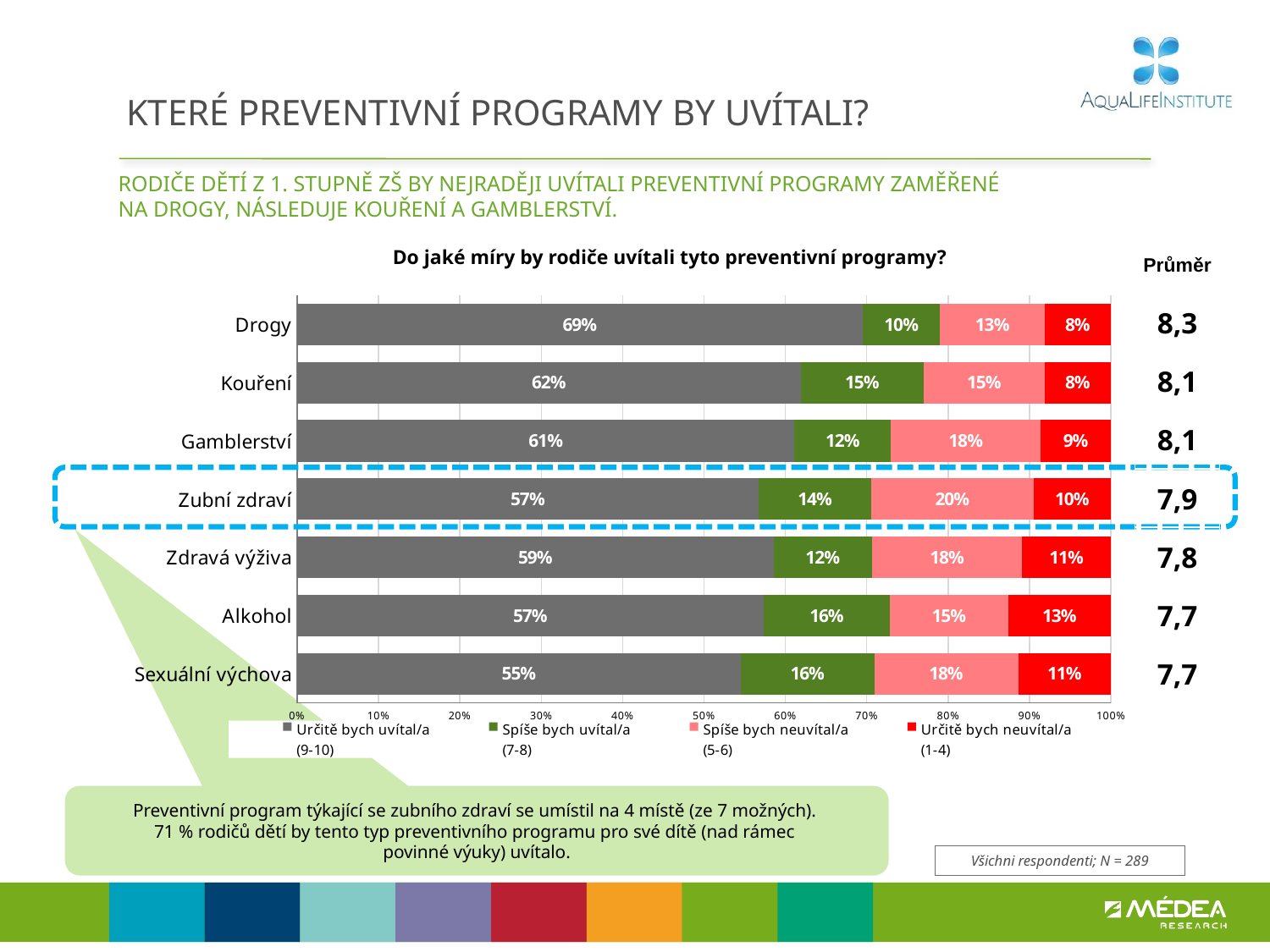
What kind of chart is shown on the slide? Stacked bar chart What is the Průměr (average) value shown for Zubní zdraví? 7,9 How many series does the legend list? 4 Which category has the highest value for "Určitě bych uvítal/a"? Drogy Which category has the highest Průměr (average) value? Drogy What is the difference between the "Určitě bych uvítal/a" values for Drogy and Kouření? 7 percentage points What is the value for "Spíše bych neuvítal/a" for Zubní zdraví? 20% Which has the larger "Určitě bych neuvítal/a" value, Alkohol or Zdravá výživa? Alkohol Which category has the lowest value for "Určitě bych uvítal/a"? Sexuální výchova What is the title of the chart? Do jaké míry by rodiče uvítali tyto preventivní programy? What is the value for "Určitě bych uvítal/a" for Drogy? 69% How many categories (preventive programs) are shown in the chart? 7